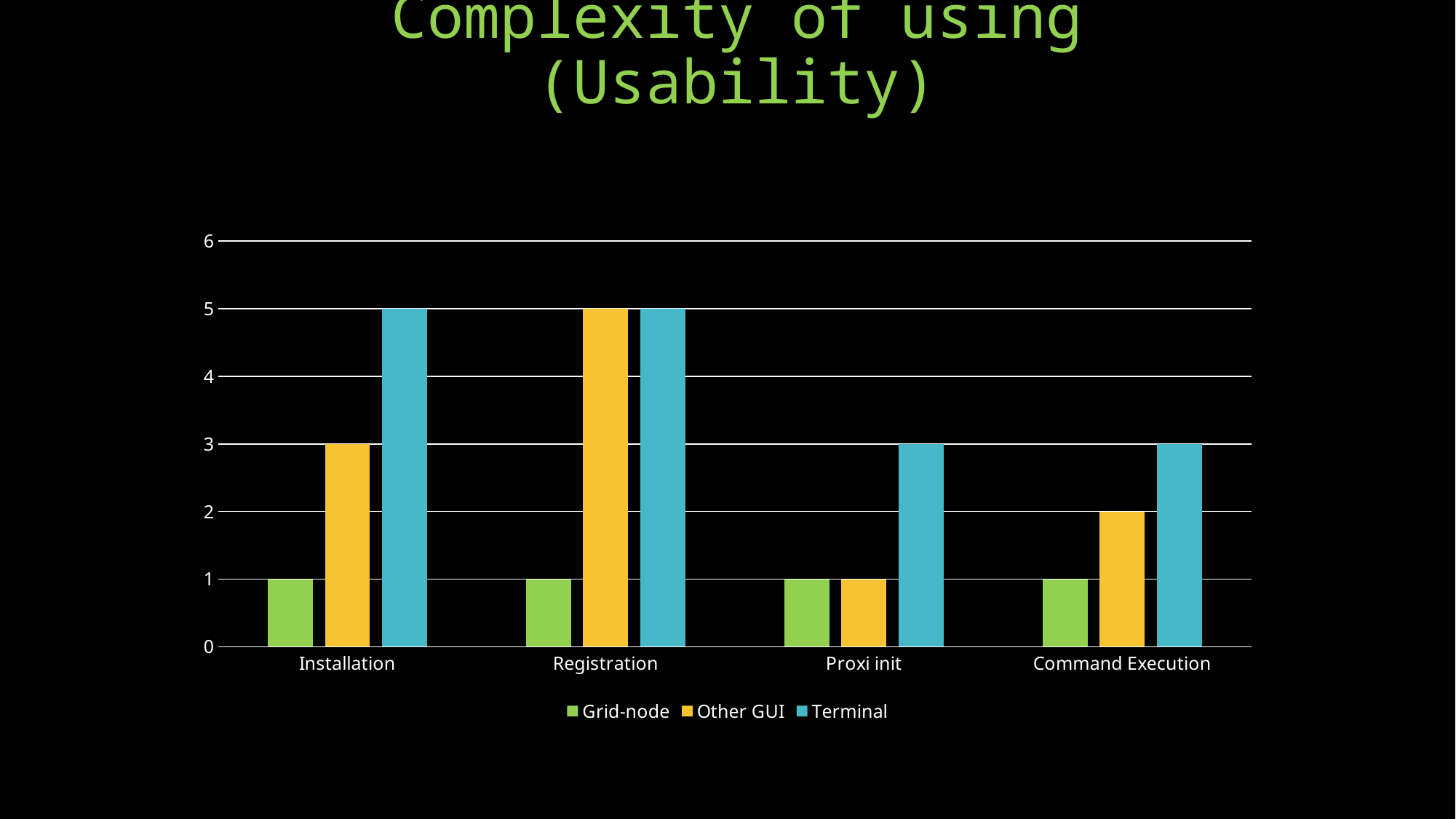
What is the difference between the Terminal and Grid-node values in the Installation category? 4 Is the value for Terminal in the Registration category greater or less than 4? greater How many series does the legend list? 3 Which series is shown in green in the legend? Grid-node In which category does Other GUI have its highest value? Registration What is the value for Other GUI in the Installation category? 3 How many categories are shown on the x axis? 4 What kind of chart is shown on the slide? bar chart Which is larger in the Proxi init category, the Terminal value or the Other GUI value? Terminal What is the value for Terminal in the Installation category? 5 What is the value for Grid-node in the Proxi init category? 1 What is the value for Other GUI in the Command Execution category? 2